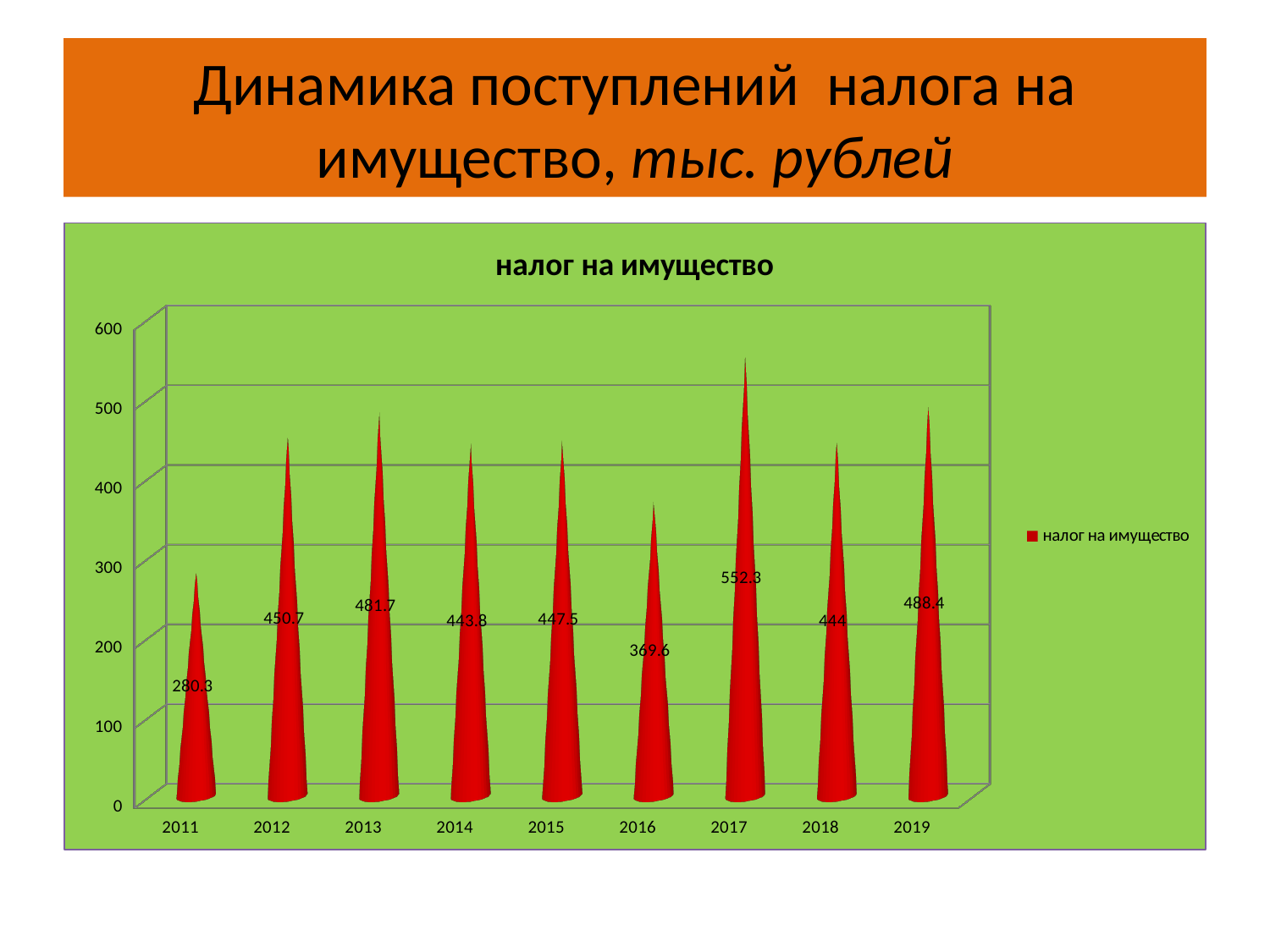
What is the difference between the values for 2019 and 2018? 44.4 Which year has the highest value? 2017 What kind of chart is shown? bar chart How many years are shown on the x axis? 9 Is the value for 2016 greater or less than 400? less Which is larger, the value for 2013 or the value for 2016? 2013 What is the value for 2011? 280.3 What is the value for 2018? 444 What is the difference between the values for 2017 and 2011? 272 How many series does the legend list? 1 What is the value for 2017? 552.3 Which year has the lowest value? 2011